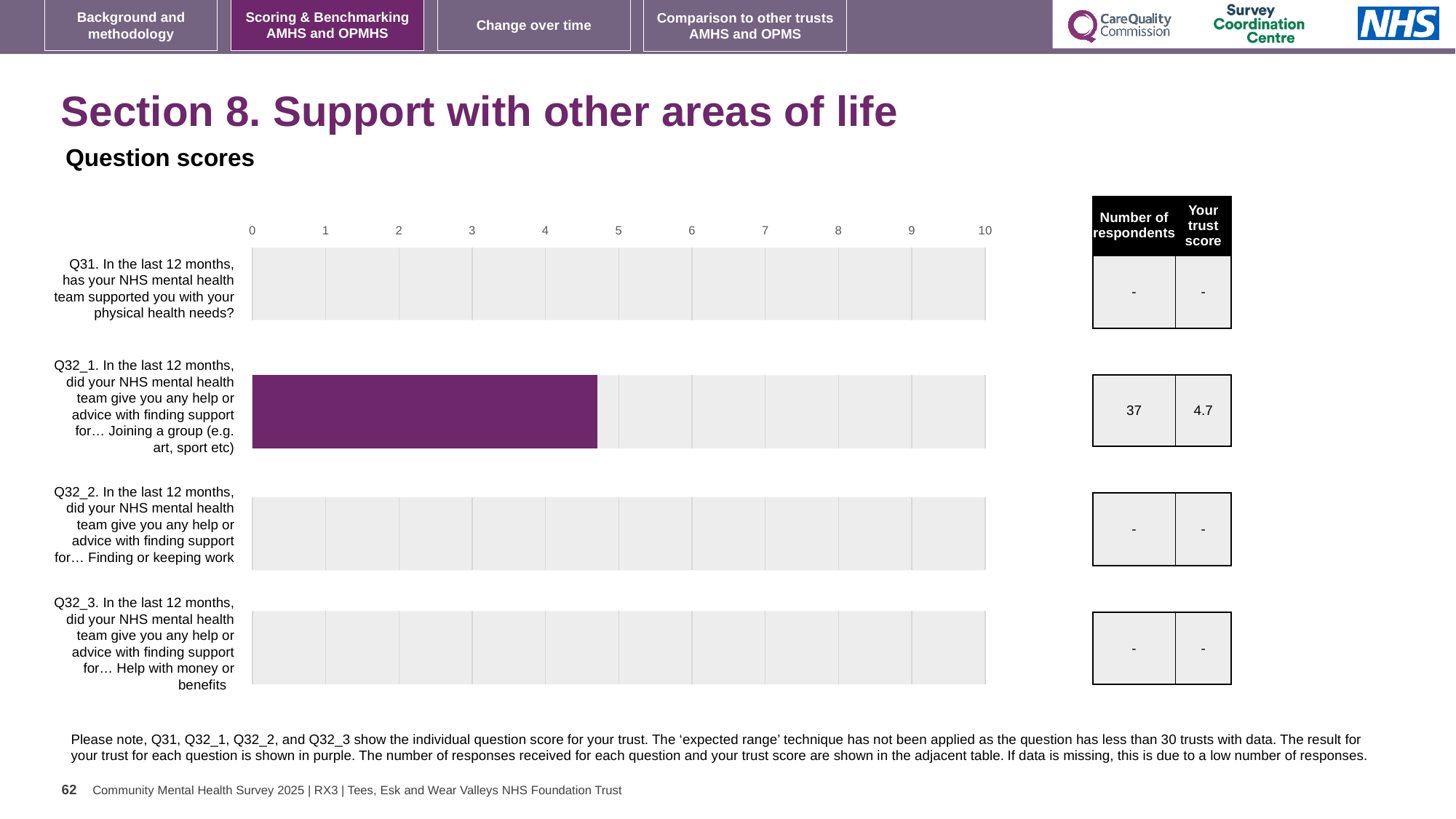
What colour is the bar showing the trust's result for Q32_1? Purple Is the trust score for Q32_1 greater or less than 5? less What is the maximum value on the chart's x axis? 10 Which question is the only one with a plotted bar on the chart? Q32_1 What is the trust score shown for Q32_3 (help with money or benefits)? - How many respondents answered Q32_1? 37 Is the trust score for Q32_1 greater or less than 4? greater What is shown in the table for the number of respondents for Q31? - What is the trust score shown for Q32_2 (finding or keeping work)? - What kind of chart is used to show the question scores? Bar chart How many questions are listed on the chart? 4 What is the trust score for Q32_1 (help or advice with finding support for joining a group)? 4.7